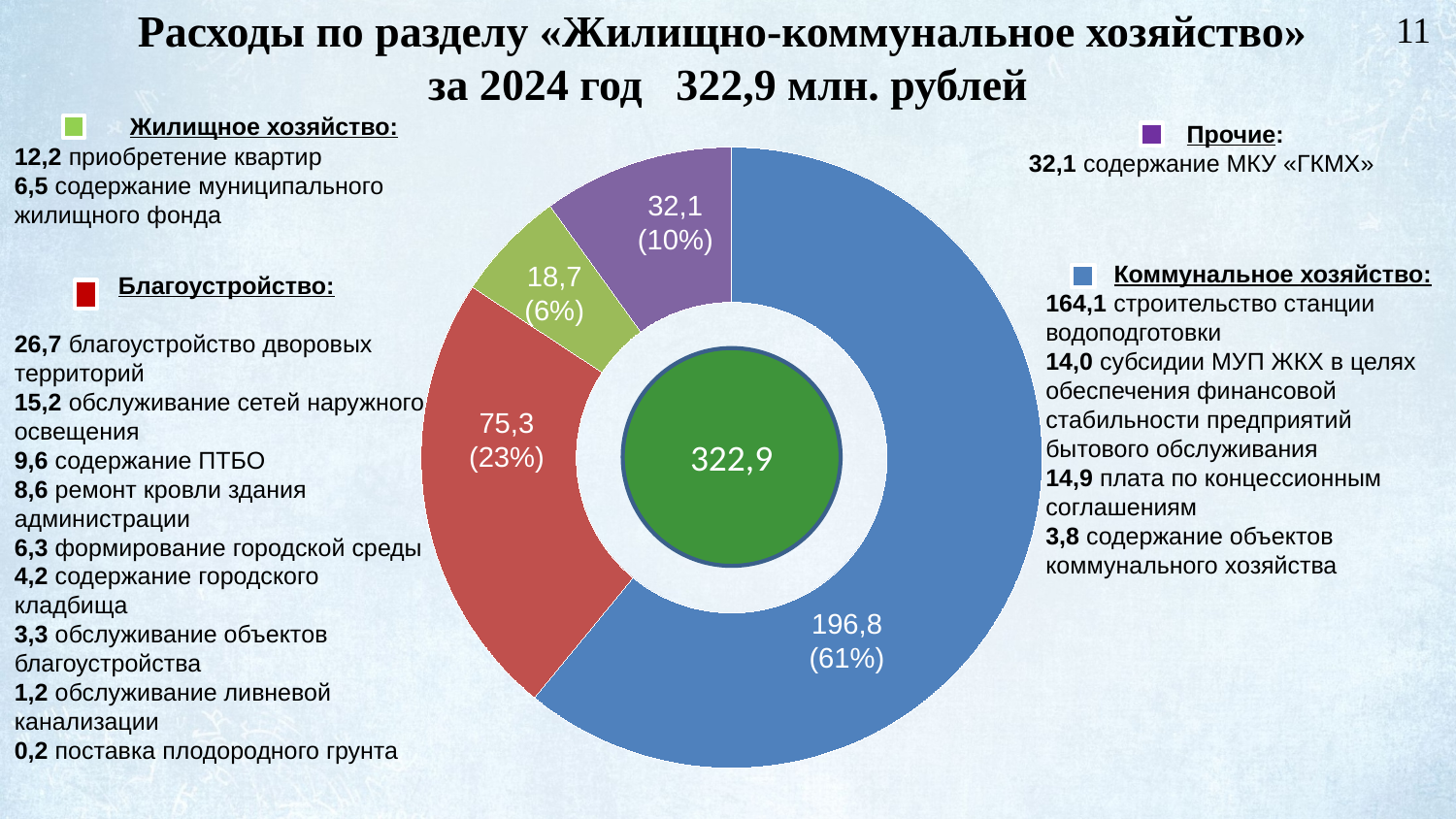
Which is larger: the value for Прочие or the value for Жилищное хозяйство? Прочие What is the value for Жилищное хозяйство in the chart? 18,7 What share of the chart does Благоустройство account for? 23% What share of the chart does Прочие account for? 10% How many segments does the chart have? 4 What is the value for Прочие in the chart? 32,1 What is the difference between the values for Коммунальное хозяйство and Благоустройство? 121,5 What is the value for Коммунальное хозяйство in the chart? 196,8 What kind of chart is shown on the slide? doughnut (pie) chart Which category has the smallest segment in the chart? Жилищное хозяйство What is the value for Благоустройство in the chart? 75,3 Which category has the largest segment in the chart? Коммунальное хозяйство